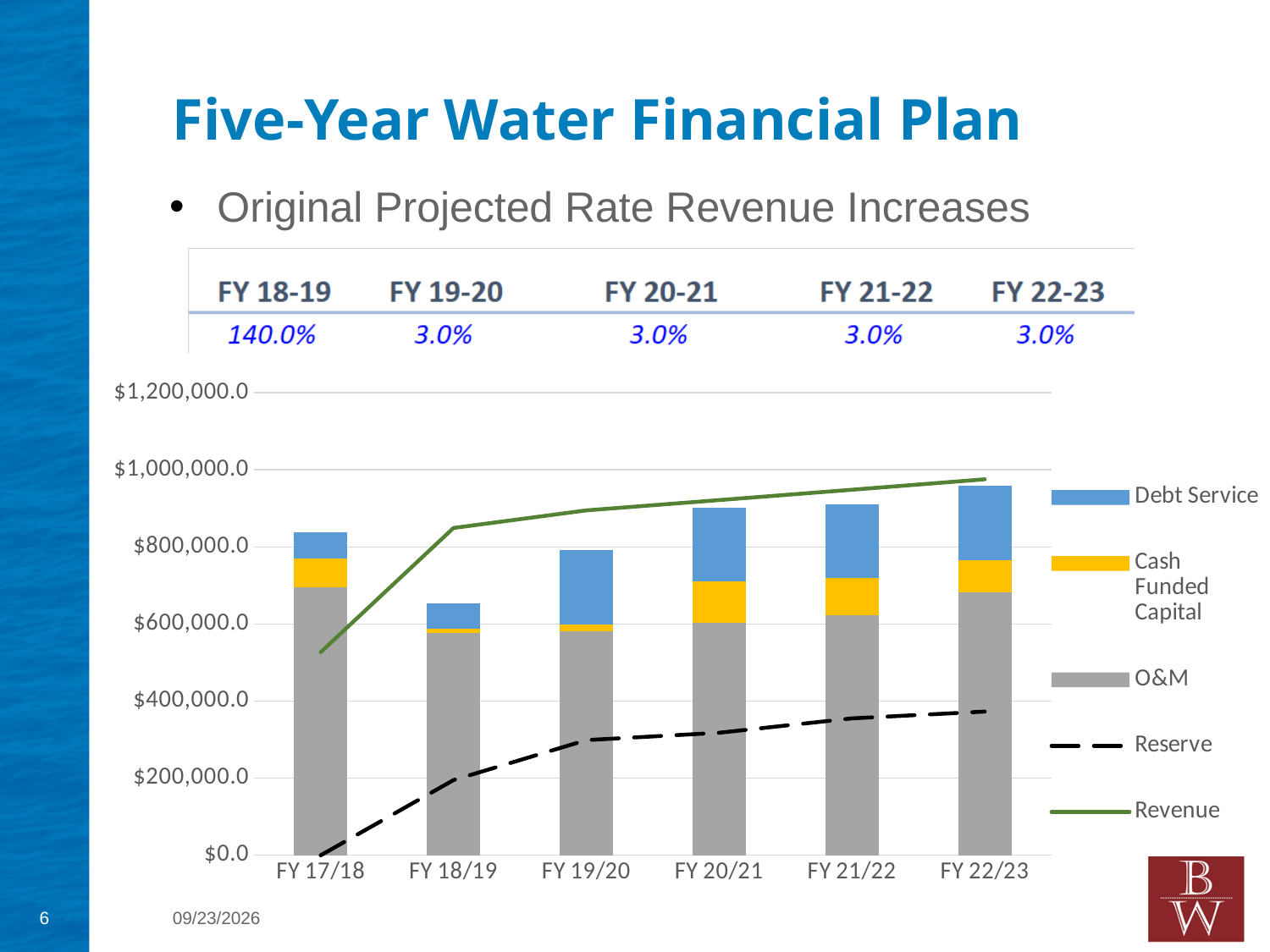
How many series does the chart legend list? 5 Which fiscal year has the tallest stacked bar? FY 22/23 Which fiscal year has the shortest stacked bar? FY 18/19 Is the O&M value for FY 17/18 greater or less than $600,000.0? greater What kind of chart is shown on the slide? combination bar and line chart (stacked bars with lines) Which is larger, the O&M segment for FY 17/18 or for FY 18/19? FY 17/18 Does the Revenue line rise or fall from FY 17/18 to FY 22/23? rise Is the Revenue line value for FY 22/23 greater or less than $1,000,000.0? less How many fiscal years are shown on the x axis of the chart? 6 Is the Revenue line value for FY 17/18 greater or less than $600,000.0? less Which series is drawn as a dashed black line in the chart? Reserve